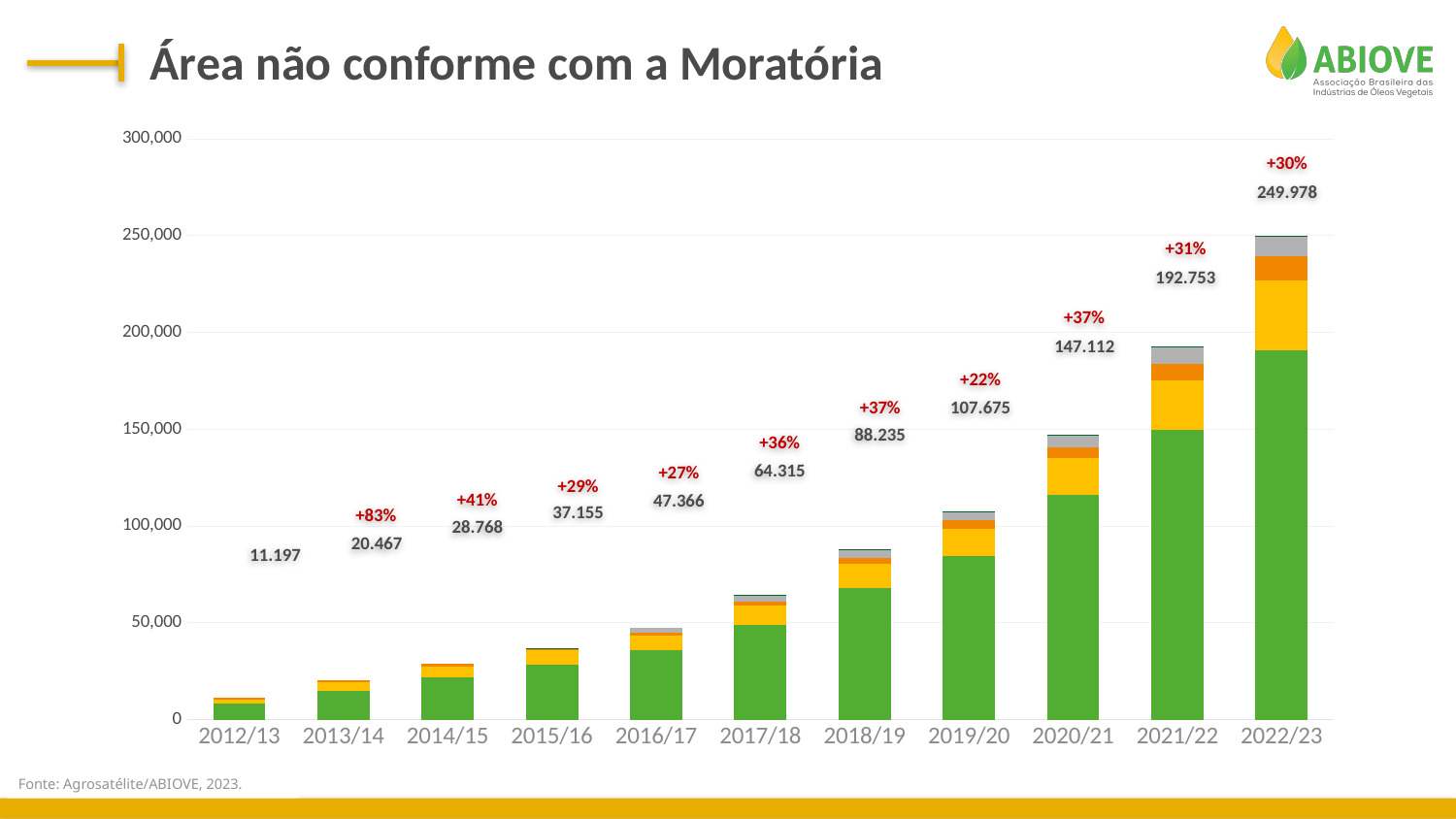
How many years are shown on the x axis? 11 What percentage change is shown above the 2013/14 bar? +83% Is the total value for 2021/22 greater or less than 200,000? less Which year has the lowest total value? 2012/13 Which year has the highest total value? 2022/23 Which is larger, the total for 2019/20 or the total for 2020/21? 2020/21 What kind of chart is shown on the slide? Stacked bar chart What is the total value shown for 2022/23? 249.978 What is the total value shown for 2012/13? 11.197 What percentage change is shown above the 2020/21 bar? +37% What is the difference between the total values for 2022/23 and 2021/22? 57.225 What is the total value shown for 2018/19? 88.235